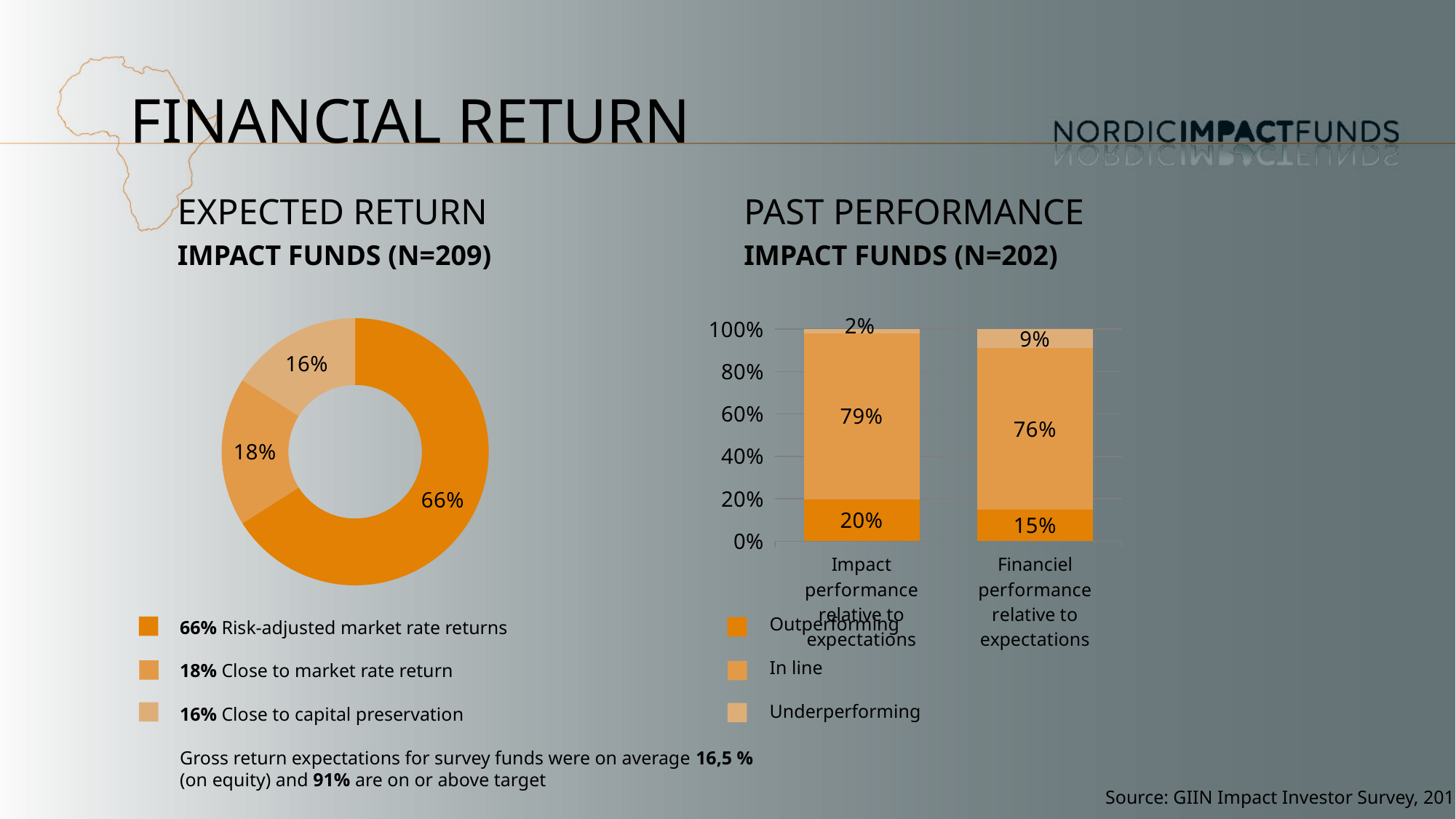
In the Past Performance chart, what percentage of funds are in line with expectations on financial performance? 76% In the Past Performance chart, which is larger: the in-line share for impact performance or the in-line share for financial performance? Impact performance (79%) How many series does the legend of the Past Performance chart list? 3 What kind of chart is the Expected Return chart? Donut (pie) chart In the Expected Return chart, what share of impact funds expect risk-adjusted market rate returns? 66% In the Past Performance chart, what percentage of funds are underperforming expectations on financial performance? 9% In the Expected Return chart, what share of impact funds expect returns close to capital preservation? 16% What kind of chart is the Past Performance chart? Stacked bar chart In the Past Performance chart, what percentage of funds are outperforming expectations on impact performance? 20% In the Expected Return chart, which category has the largest share? Risk-adjusted market rate returns In the Expected Return chart, what is the difference between the share for risk-adjusted market rate returns and the share for close to market rate return? 48% In the Expected Return chart, which category has the smallest share? Close to capital preservation